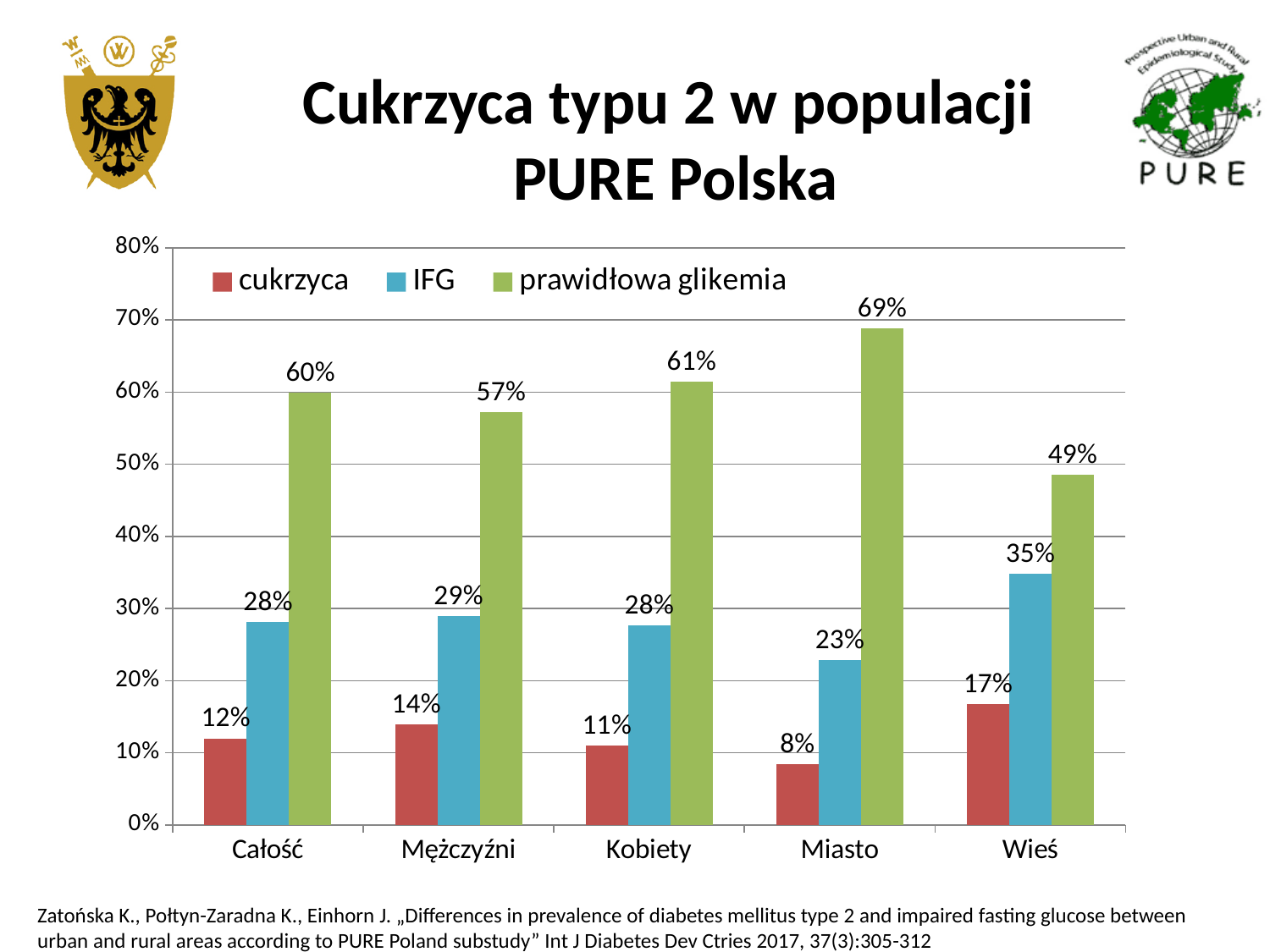
Which is larger, the cukrzyca value for Wieś or for Całość? Wieś Is the value for IFG in the Miasto category greater or less than 30%? less What is the value for IFG in the Wieś category? 35% What is the value for cukrzyca in the Miasto category? 8% What is the difference between the prawidłowa glikemia values for Miasto and Wieś? 20% How many categories are shown on the x axis? 5 Which category has the highest value for prawidłowa glikemia? Miasto What is the title of the slide? Cukrzyca typu 2 w populacji PURE Polska What is the value for prawidłowa glikemia in the Mężczyźni category? 57% What kind of chart is shown on the slide? bar chart Which category has the lowest value for cukrzyca? Miasto How many series does the legend list? 3